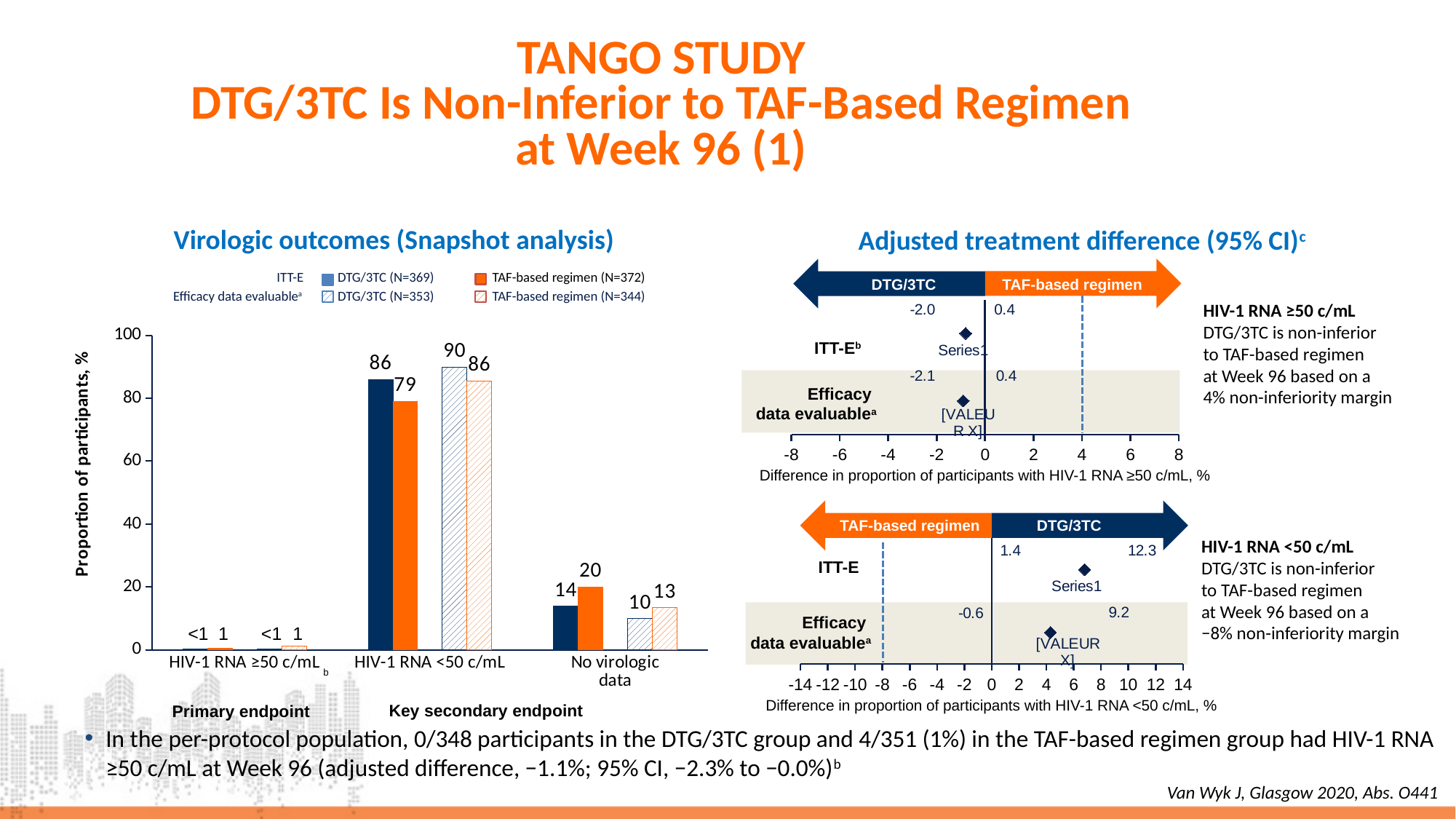
In the Virologic outcomes (Snapshot analysis) chart, which series has the highest value in the HIV-1 RNA <50 c/mL category? DTG/3TC (N=353) In the Virologic outcomes (Snapshot analysis) chart, what is the value for TAF-based regimen (N=372) in the No virologic data category? 20 In the Virologic outcomes (Snapshot analysis) chart, what is the value for DTG/3TC (N=353) in the HIV-1 RNA <50 c/mL category? 90 In the Virologic outcomes (Snapshot analysis) chart, how many series does the legend list? 4 In the Virologic outcomes (Snapshot analysis) chart, what is the difference between DTG/3TC (N=369) and TAF-based regimen (N=372) in the HIV-1 RNA <50 c/mL category? 7 In the Virologic outcomes (Snapshot analysis) chart, which is larger in the No virologic data category: DTG/3TC (N=369) or TAF-based regimen (N=372)? TAF-based regimen (N=372) What kind of chart is the Virologic outcomes (Snapshot analysis) chart? Bar chart In the upper Adjusted treatment difference chart (HIV-1 RNA ≥50 c/mL), what are the confidence interval bounds printed for ITT-E? -2.0 and 0.4 In the Virologic outcomes (Snapshot analysis) chart, how many categories are shown on the x axis? 3 In the Virologic outcomes (Snapshot analysis) chart, what is the value for DTG/3TC (N=369) in the HIV-1 RNA <50 c/mL category? 86 In the Virologic outcomes (Snapshot analysis) chart, what is the value for DTG/3TC (N=353) in the No virologic data category? 10 In the Virologic outcomes (Snapshot analysis) chart, what is the value for TAF-based regimen (N=372) in the HIV-1 RNA <50 c/mL category? 79